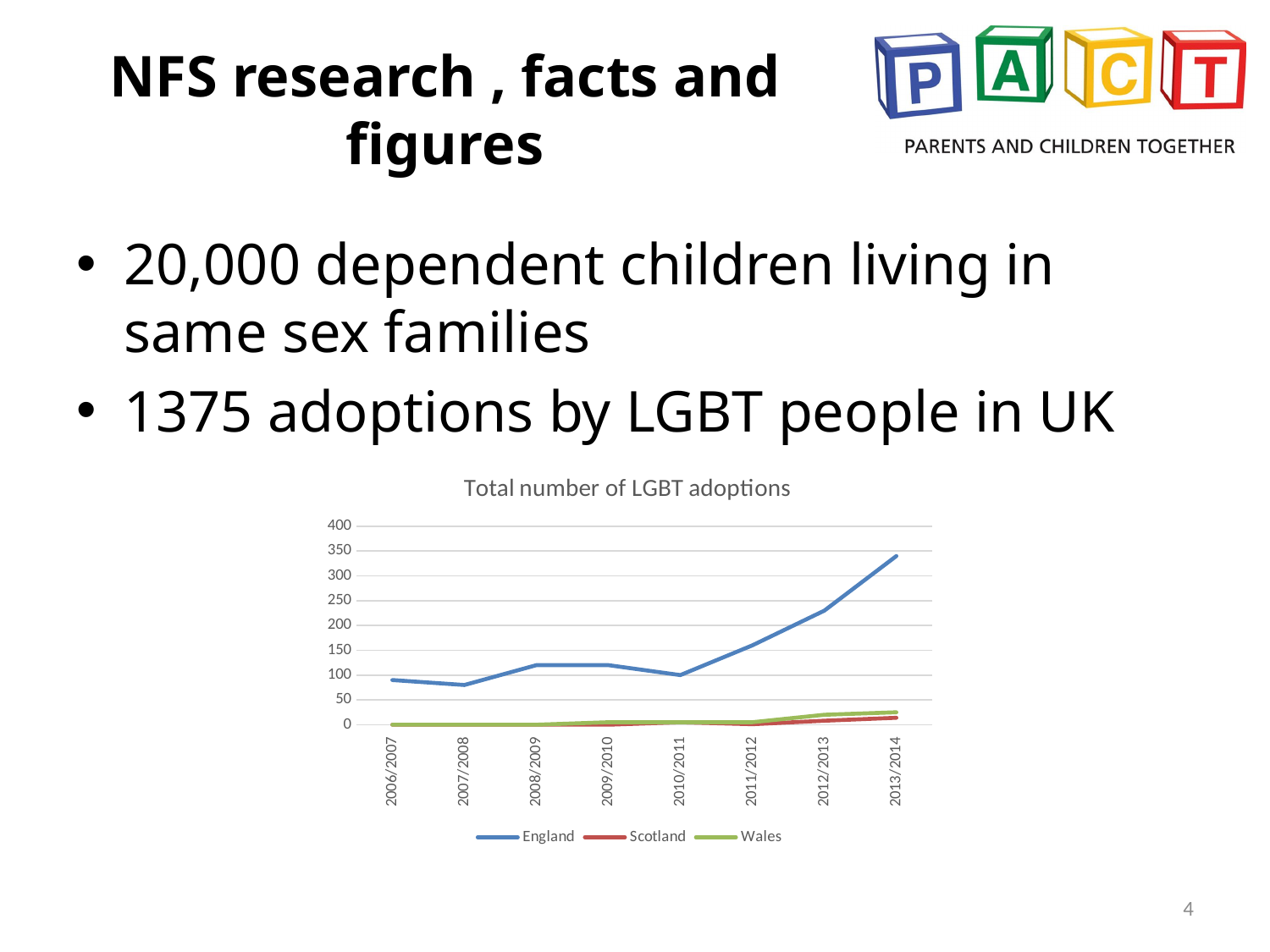
Is the value for England in 2013/2014 greater or less than 300? greater Is the value for Wales in 2013/2014 greater or less than 50? less Which series has the highest values throughout the chart? England Does the England series rise or fall between 2010/2011 and 2013/2014? rise Is the value for England in 2012/2013 greater or less than 200? greater How many series does the chart's legend list? 3 Which is larger in 2013/2014, the value for England or the value for Scotland? England What is the title of the chart? Total number of LGBT adoptions How many year categories are shown along the x axis of the chart? 8 In which year does the England series reach its highest value? 2013/2014 What kind of chart is shown on the slide? line chart